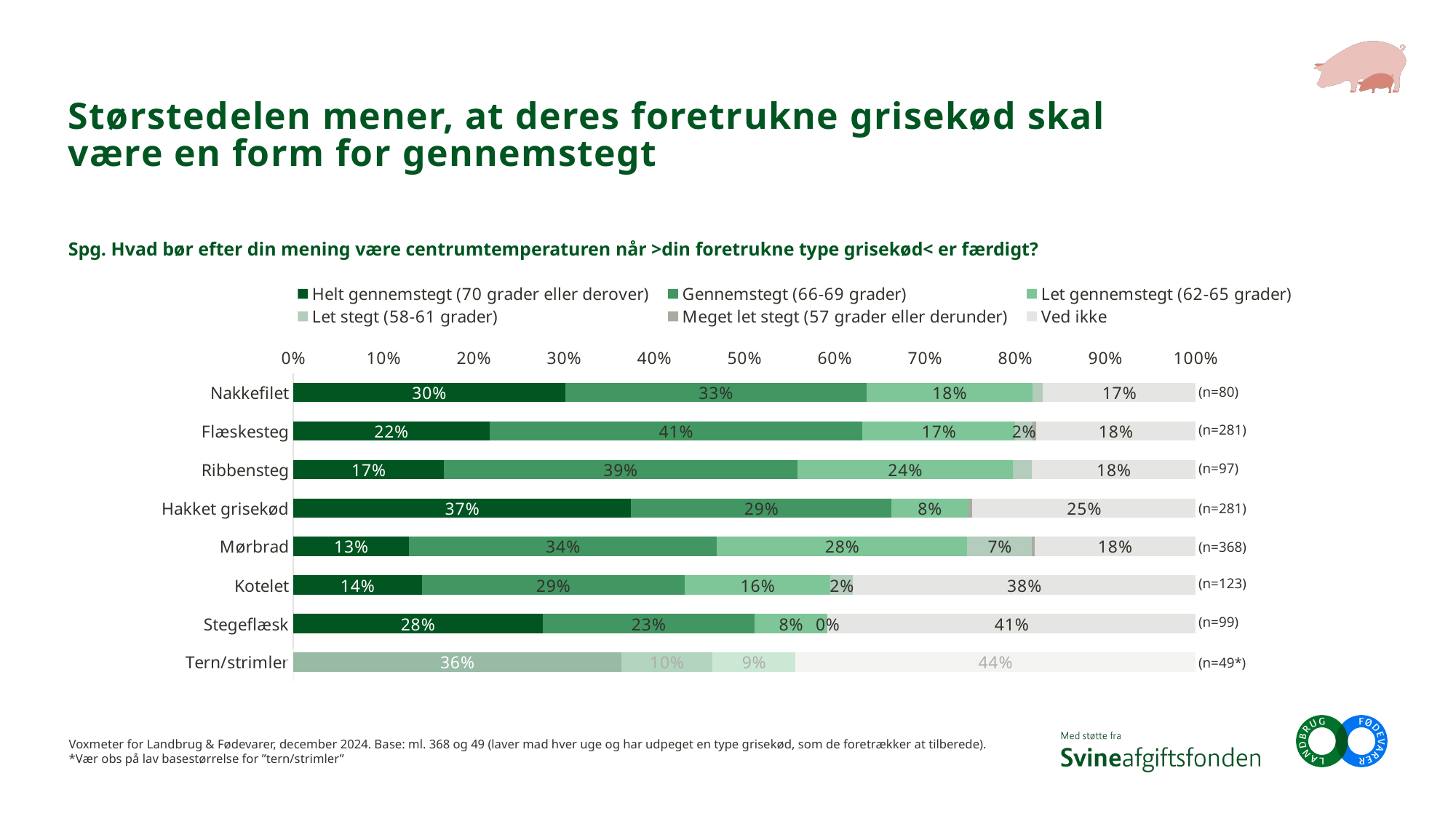
What is the difference in the 'Gennemstegt (66-69 grader)' share between Flæskesteg and Ribbensteg? 2 percentage points Which category has the lowest share for 'Helt gennemstegt (70 grader eller derover)'? Mørbrad What share of respondents chose 'Helt gennemstegt (70 grader eller derover)' for Hakket grisekød? 37% Which category has the highest share for 'Helt gennemstegt (70 grader eller derover)'? Hakket grisekød Which category has the highest 'Ved ikke' share? Tern/strimler Which has the larger 'Ved ikke' share, Kotelet or Hakket grisekød? Kotelet How many series does the legend list? 6 What is the base size (n) shown for Mørbrad? n=368 What kind of chart is shown on the slide? Stacked bar chart What is the 'Ved ikke' share for Stegeflæsk? 41% What is the 'Let gennemstegt (62-65 grader)' share for Ribbensteg? 24% How many types of pork (categories) are shown on the chart? 8